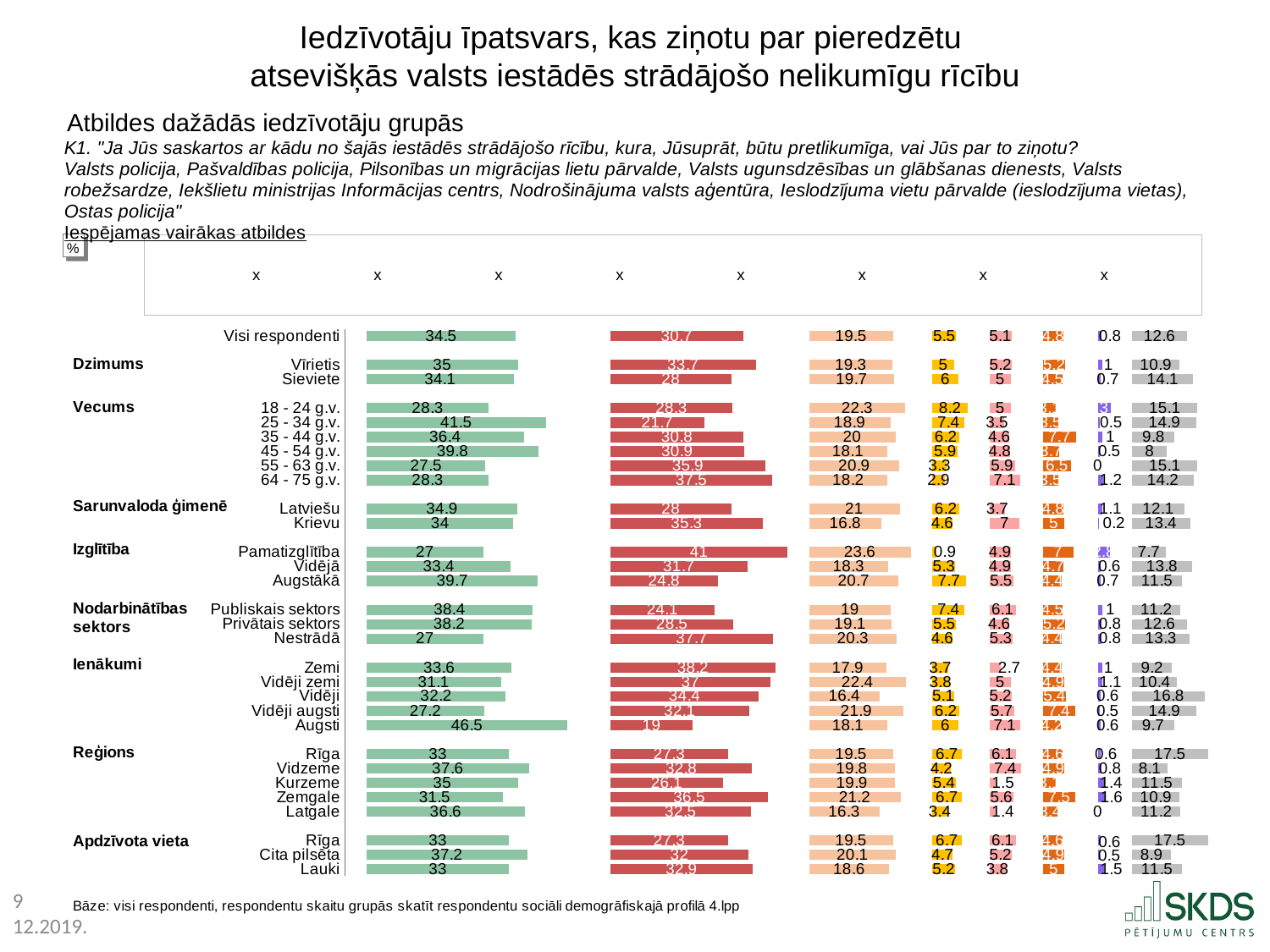
What is the value of the last (grey) bar for "Rīga" under "Reģions"? 17.5 How many categories are listed under "Reģions"? 5 Among the "Vecums" age groups, which has the lowest green bar value? 55 - 63 g.v. In the red bar series, which is larger: "Pamatizglītība" or "Augstākā"? Pamatizglītība What is the difference between the orange bar values for "Latviešu" (21) and "Krievu" (16.8)? 4.2 What is the value of the red bar for "Nestrādā"? 37.7 What is the value of the green bar for the "Augsti" income group? 46.5 What is the difference between the green bar values for "Vīrietis" (35) and "Sieviete" (34.1)? 0.9 What type of chart is shown on the slide? bar chart Among the "Vecums" age groups, which has the highest green bar value? 25 - 34 g.v. What is the value of the red bar for the "Augsti" income group? 19 What is the value of the first (green) bar for "Visi respondenti"? 34.5